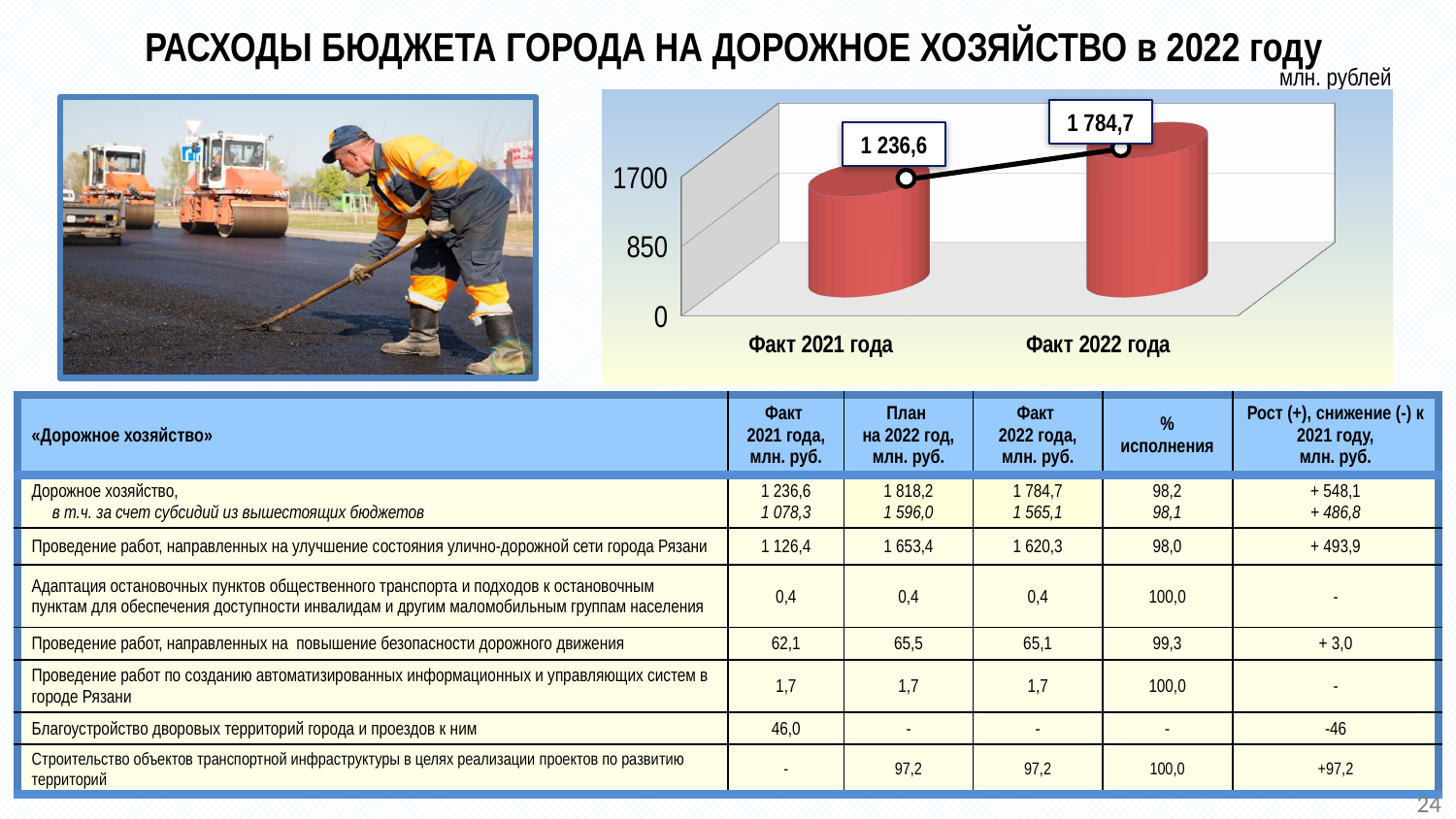
What is the value for Факт 2021 года on the chart? 1 236,6 Which category has the highest value on the chart? Факт 2022 года How many categories are shown on the chart? 2 What kind of chart is shown on the slide? bar chart Which category has the lowest value on the chart? Факт 2021 года Do the values rise or fall from Факт 2021 года to Факт 2022 года on the chart? rise Is the value for Факт 2021 года greater or less than 1700? less Is the value for Факт 2022 года greater or less than 1700? greater What unit is indicated above the chart? млн. рублей Which is larger on the chart: the value for Факт 2021 года or the value for Факт 2022 года? Факт 2022 года What is the value for Факт 2022 года on the chart? 1 784,7 What is the difference between the values for Факт 2022 года and Факт 2021 года on the chart? 548,1